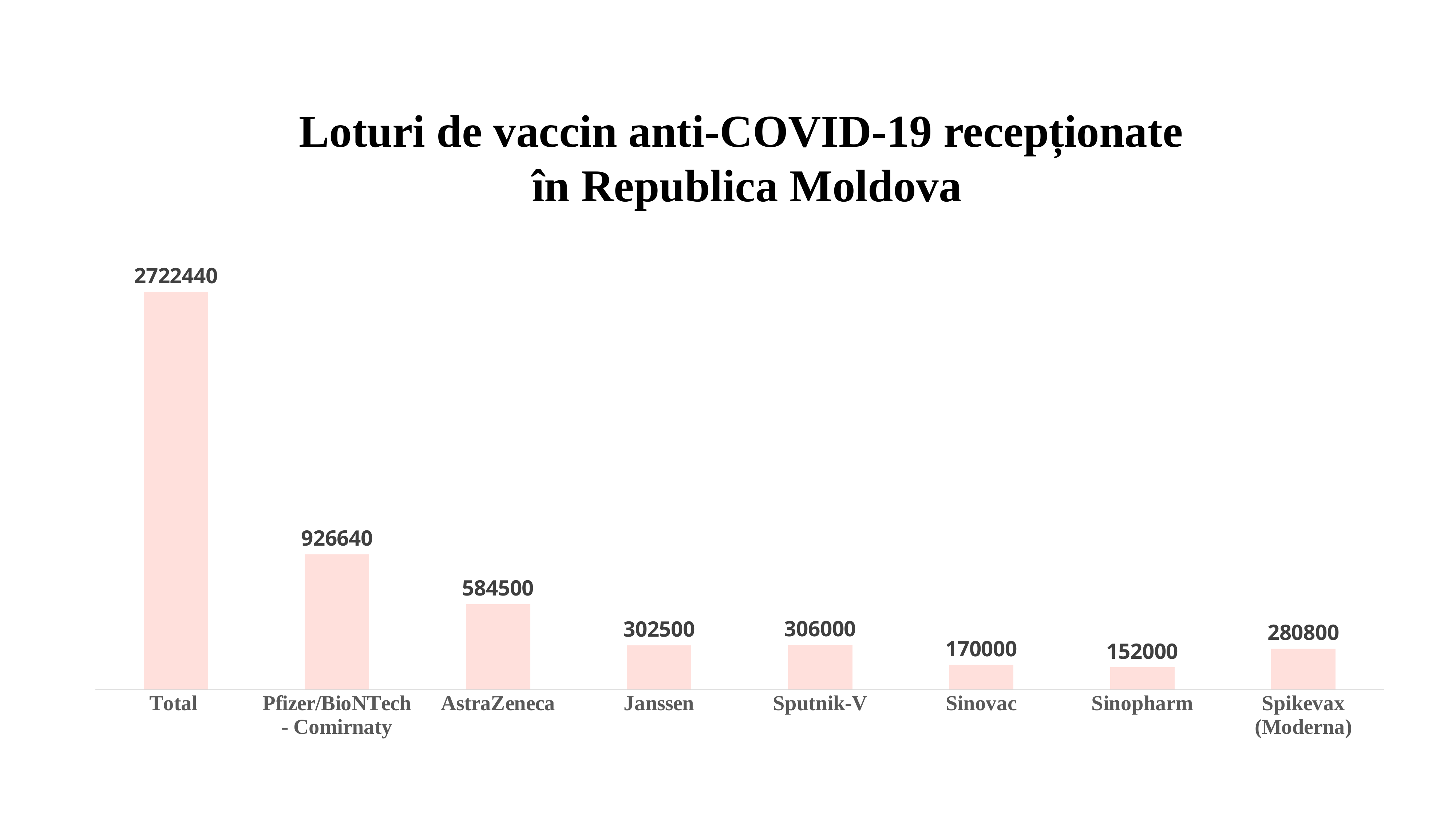
Which category has the lowest value? Sinopharm Which is larger, the value for Janssen or the value for Sputnik-V? Sputnik-V Excluding the Total bar, which vaccine has the highest value? Pfizer/BioNTech - Comirnaty What is the value for Pfizer/BioNTech - Comirnaty? 926640 What is the value shown for Total? 2722440 What is the difference between the values for Pfizer/BioNTech - Comirnaty and AstraZeneca? 342140 How many bars are shown in the chart? 8 What kind of chart is shown on the slide? Bar chart What is the value for Spikevax (Moderna)? 280800 What is the value for AstraZeneca? 584500 What is the difference between the values for Sinovac and Sinopharm? 18000 What is the value for Sputnik-V? 306000